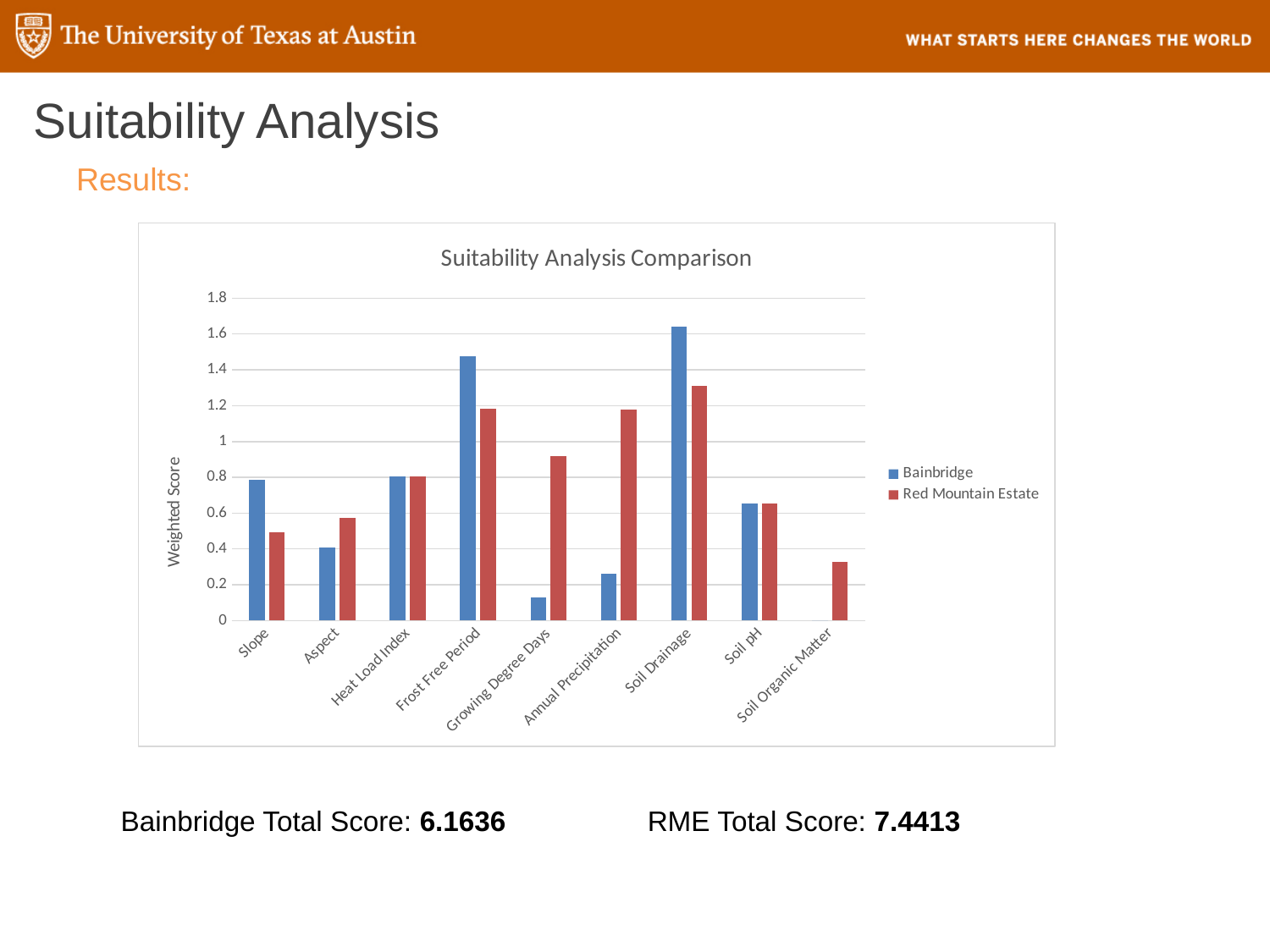
For which category is the Red Mountain Estate value highest? Soil Drainage For Slope, which series has the larger value, Bainbridge or Red Mountain Estate? Bainbridge How many series does the legend of the chart list? 2 What is the title of the chart? Suitability Analysis Comparison Is the Bainbridge value for Growing Degree Days greater or less than 0.2? less What is the label on the vertical axis of the chart? Weighted Score Is the Bainbridge value for Soil Drainage greater or less than 1.4? greater For which category is the Red Mountain Estate value lowest? Soil Organic Matter What kind of chart is shown on the slide? Bar chart How many categories are shown along the x axis of the chart? 9 For which category is the Bainbridge value highest? Soil Drainage Is the Red Mountain Estate value for Annual Precipitation greater or less than 1? greater